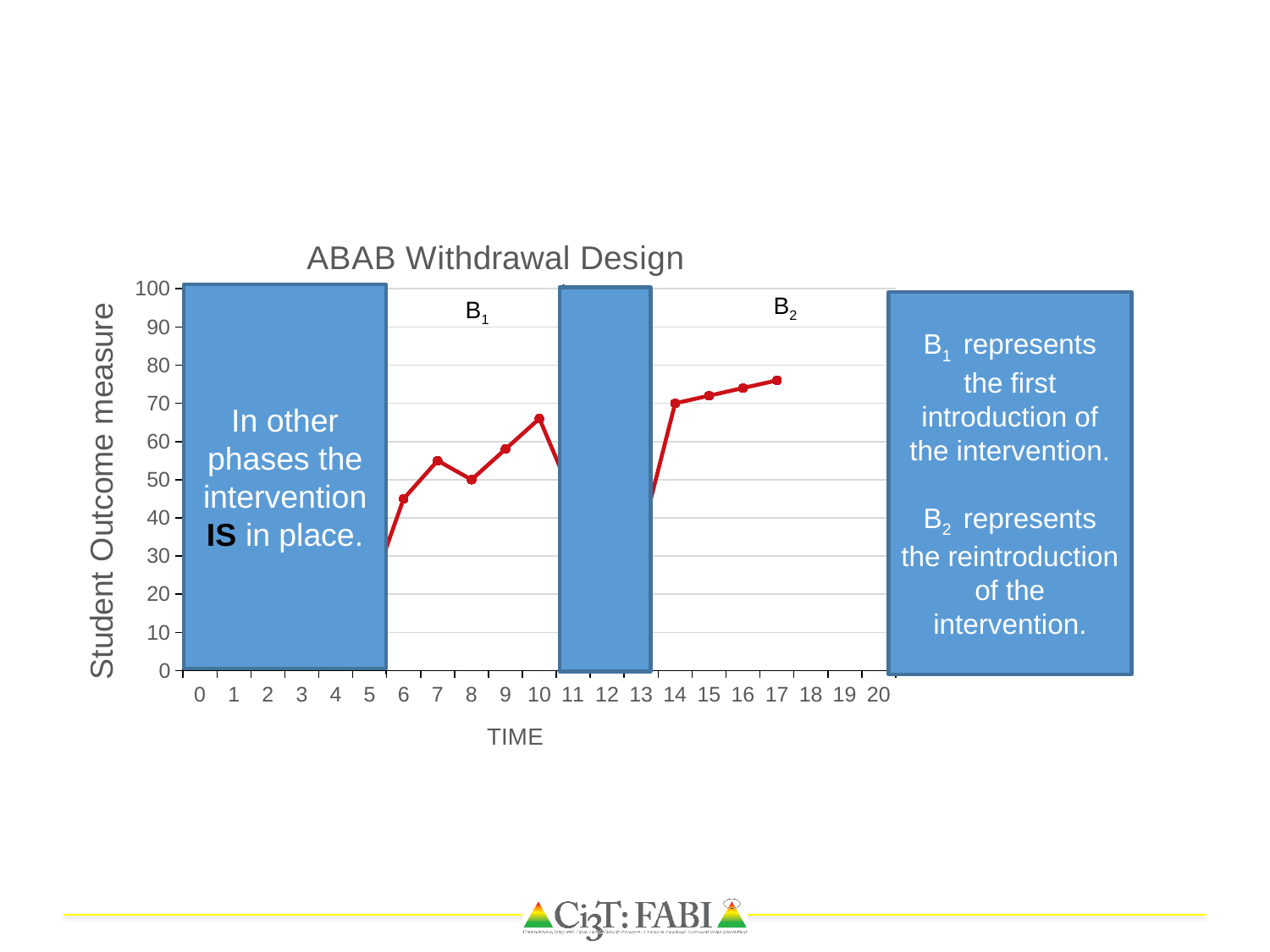
Which is larger, the value at time 10 or the value at time 6? time 10 What kind of chart is shown on the slide? line chart Is the value at time 14 greater or less than 60? greater Among the visible data points, at which time is the value lowest? 6 Is the value at time 8 greater or less than 60? less Is the value at time 17 greater or less than 70? greater Among the visible data points, at which time is the value highest? 17 What is the label of the vertical axis? Student Outcome measure What is the title of the chart? ABAB Withdrawal Design Do the values rise or fall from time 14 to time 17 in the B2 phase? rise